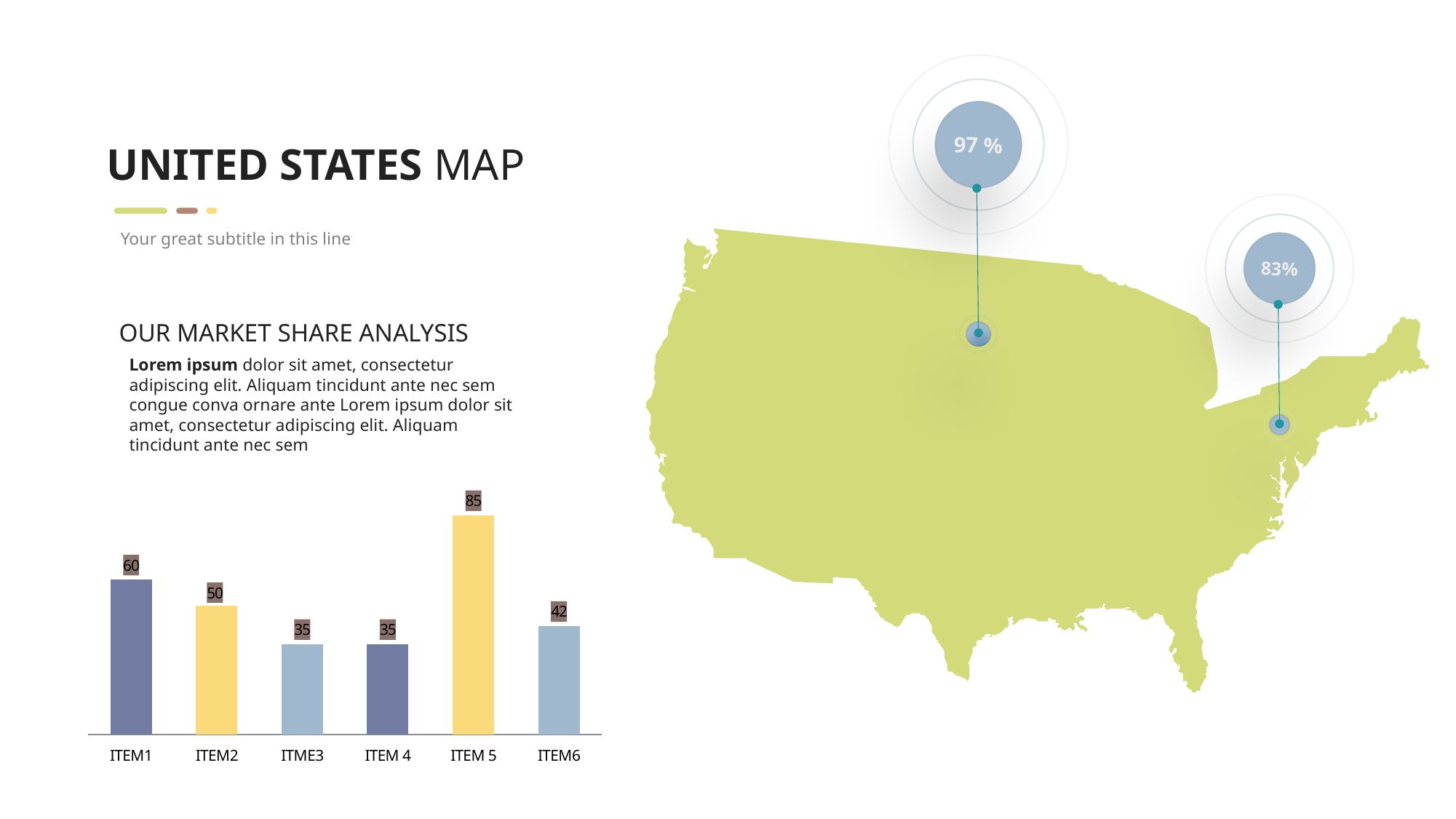
What is the difference between the values for ITEM 5 and ITEM1 in the bar chart? 25 What is the value for ITEM6 in the bar chart? 42 How many categories are shown in the bar chart? 6 What is the heading printed above the bar chart? OUR MARKET SHARE ANALYSIS What is the difference between the values for ITEM2 and ITEM6 in the bar chart? 8 Which two categories in the bar chart share the same value? ITME3 and ITEM 4 Which is larger in the bar chart, the value for ITEM1 or the value for ITEM6? ITEM1 What kind of chart is shown on the slide? bar chart Which category has the highest value in the bar chart? ITEM 5 What is the value for ITEM1 in the bar chart? 60 What is the value for ITEM2 in the bar chart? 50 What is the value for ITEM 5 in the bar chart? 85